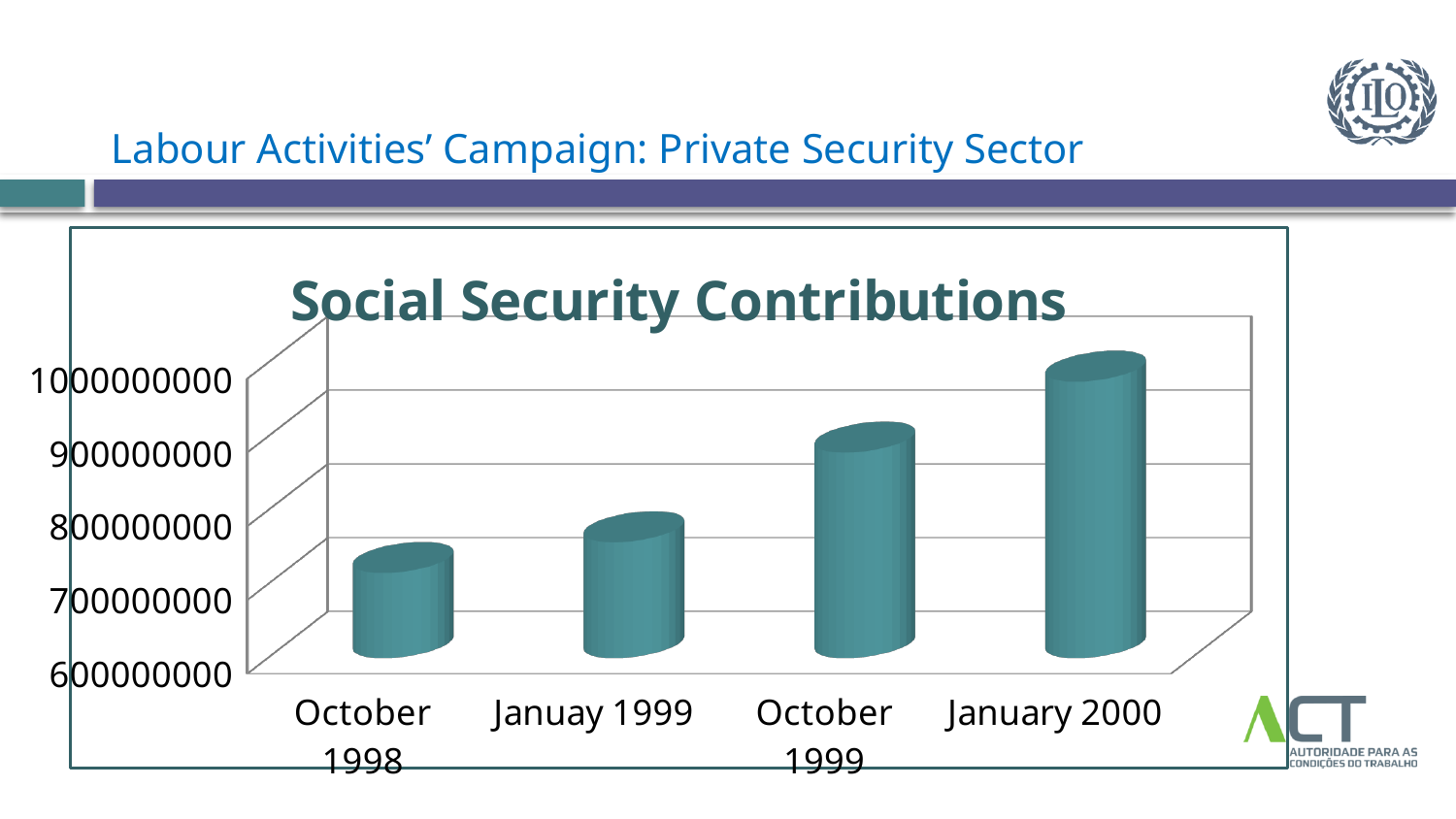
What is the title of the chart? Social Security Contributions Which category has the lowest social security contributions? October 1998 Which is larger, the value for October 1999 or the value for Januay 1999? October 1999 Is the value for October 1998 greater or less than 800000000? less Is the value for October 1999 greater or less than 800000000? greater Which category has the highest social security contributions? January 2000 How many categories are plotted on the x axis of the chart? 4 Is the value for Januay 1999 greater or less than 700000000? greater Do the social security contributions rise or fall from October 1998 to January 2000? rise What is the lowest value shown on the vertical axis of the chart? 600000000 What kind of chart is shown on the slide? bar chart